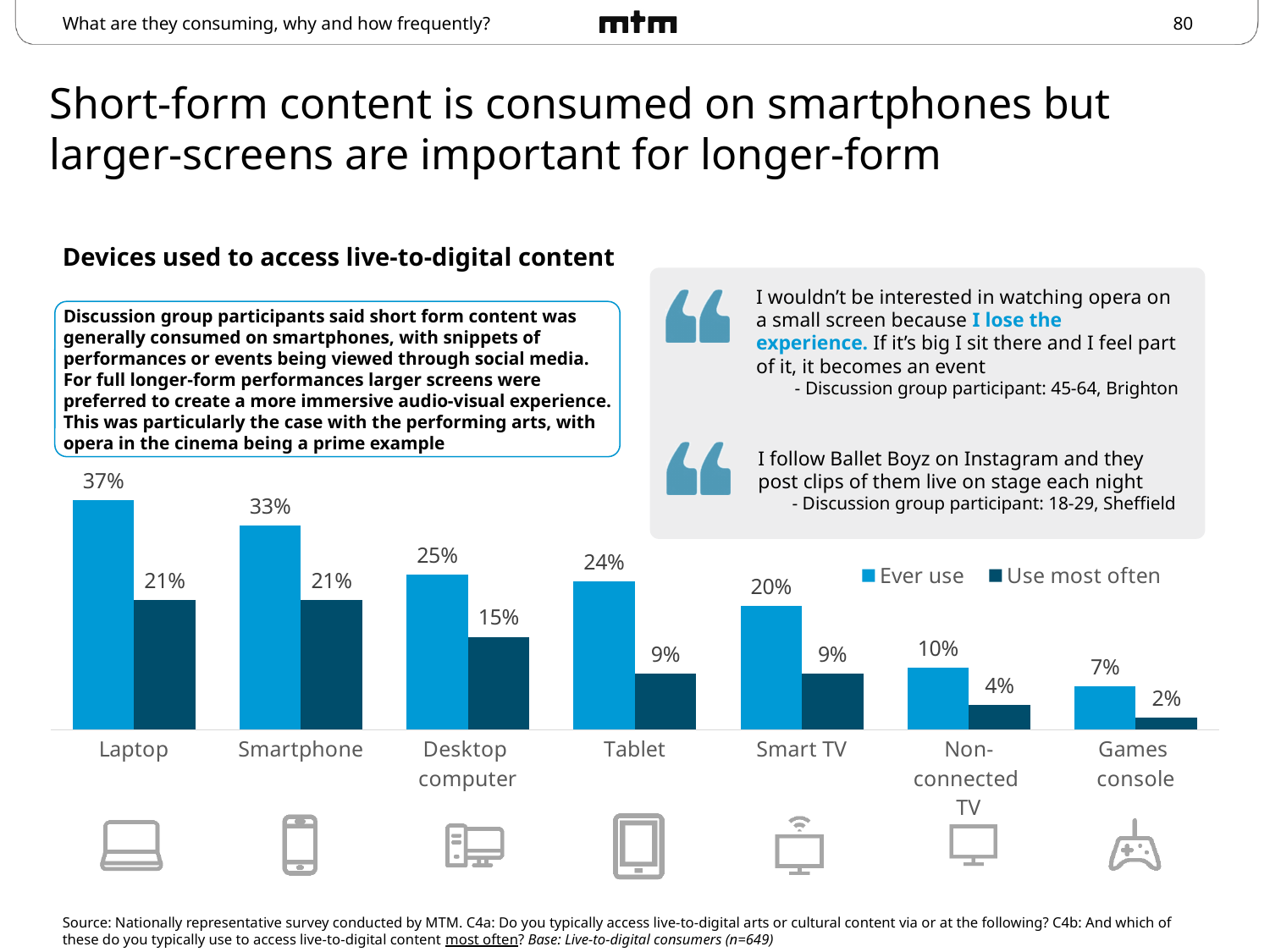
Which device has the lowest 'Use most often' value? Games console What is the 'Use most often' value for Desktop computer? 15% How many series does the legend list? 2 Which device has the highest 'Ever use' value? Laptop What kind of chart is shown on the slide? Bar chart What is the title of the chart? Devices used to access live-to-digital content What is the difference between the 'Ever use' and 'Use most often' values for Smartphone? 12% What is the 'Ever use' value for Laptop? 37% Which is larger: the 'Ever use' value for Tablet or the 'Ever use' value for Smart TV? Tablet What is the 'Ever use' value for Non-connected TV? 10% Do the 'Ever use' values rise or fall moving from Laptop to Games console along the x axis? Fall How many device categories are shown on the x axis? 7